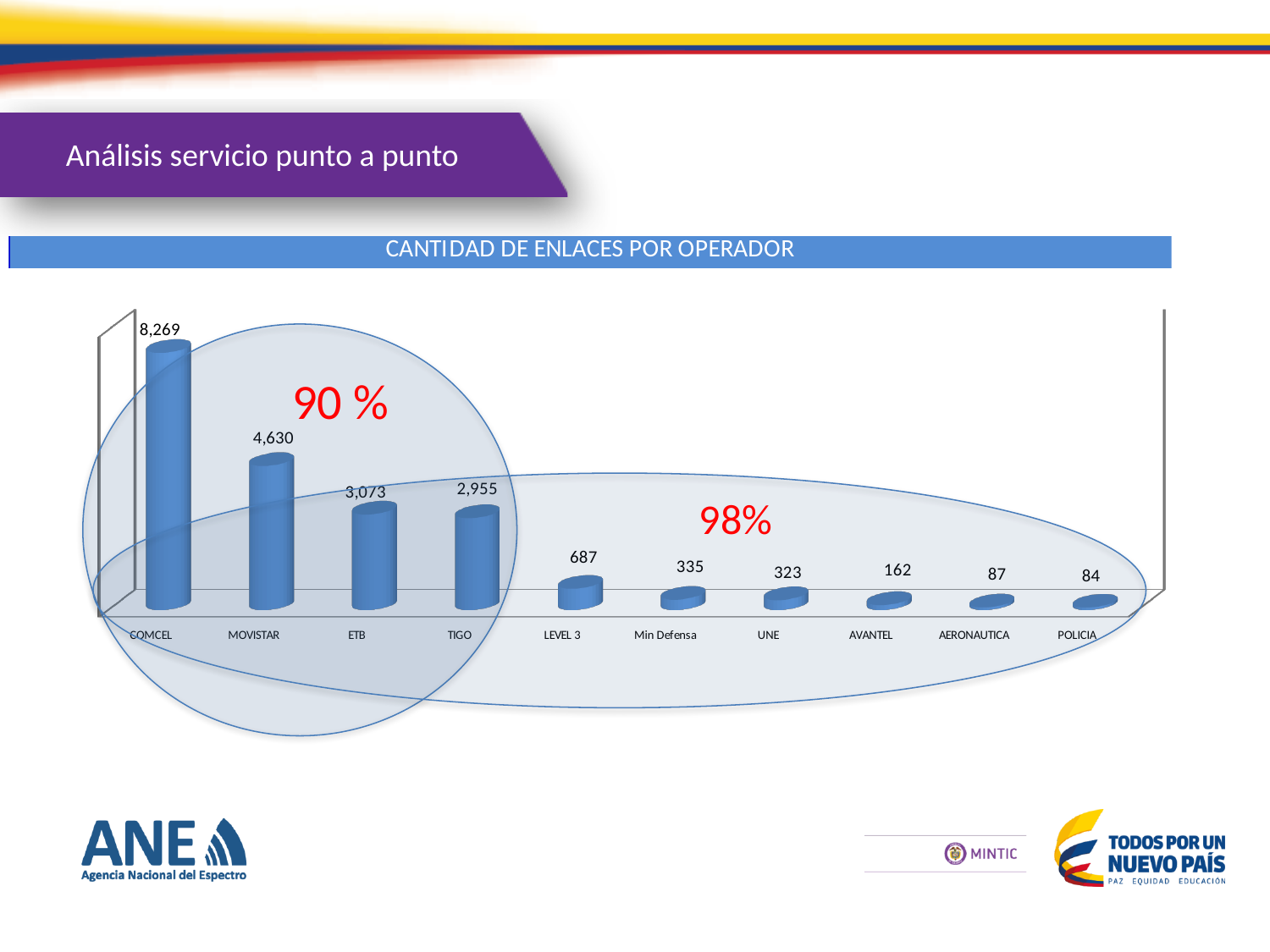
What is the value for MOVISTAR? 4,630 What is the value for COMCEL? 8,269 Which operator has the lowest number of links? POLICIA Which is larger, the value for Min Defensa or the value for UNE? Min Defensa What kind of chart is shown on the slide? Bar chart What is the difference between the values for COMCEL and MOVISTAR? 3,639 What is the title of the chart? CANTIDAD DE ENLACES POR OPERADOR Which operator has the highest number of links? COMCEL What is the difference between the values for ETB and TIGO? 118 How many operators are shown on the chart? 10 What is the value for LEVEL 3? 687 What is the value for POLICIA? 84